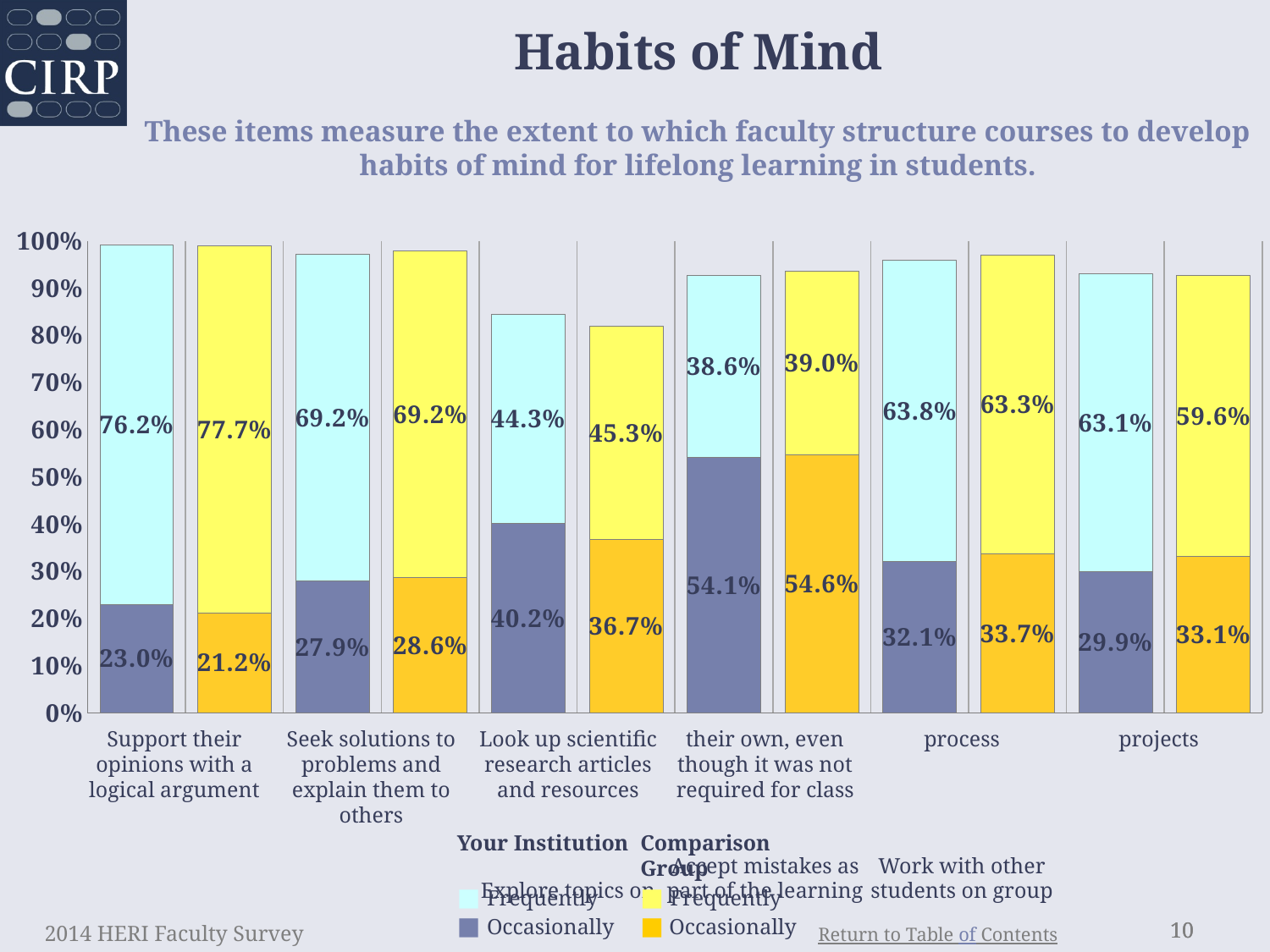
What is the lowest 'Frequently' value shown among the Your Institution bars? 38.6% Which item has the highest 'Frequently' value for Your Institution? Support their opinions with a logical argument How many entries does the chart legend list? 4 What percentage of Your Institution faculty report 'Frequently' for 'Support their opinions with a logical argument'? 76.2% What is the Your Institution 'Occasionally' value for 'Look up scientific research articles and resources'? 40.2% How many items (categories) are shown along the x axis of the chart? 6 For 'Look up scientific research articles and resources', which is larger: the Your Institution 'Occasionally' value or the Comparison Group 'Occasionally' value? Your Institution (40.2%) What is the Comparison Group 'Occasionally' value for 'Seek solutions to problems and explain them to others'? 28.6% What kind of chart is shown on the slide? Stacked bar chart What is the total height of the Your Institution stacked bar for 'Support their opinions with a logical argument'? 99.2% What is the total height of the Comparison Group stacked bar for 'Look up scientific research articles and resources'? 82.0% What is the difference between the Comparison Group and Your Institution 'Frequently' values for 'Support their opinions with a logical argument'? 1.5 percentage points